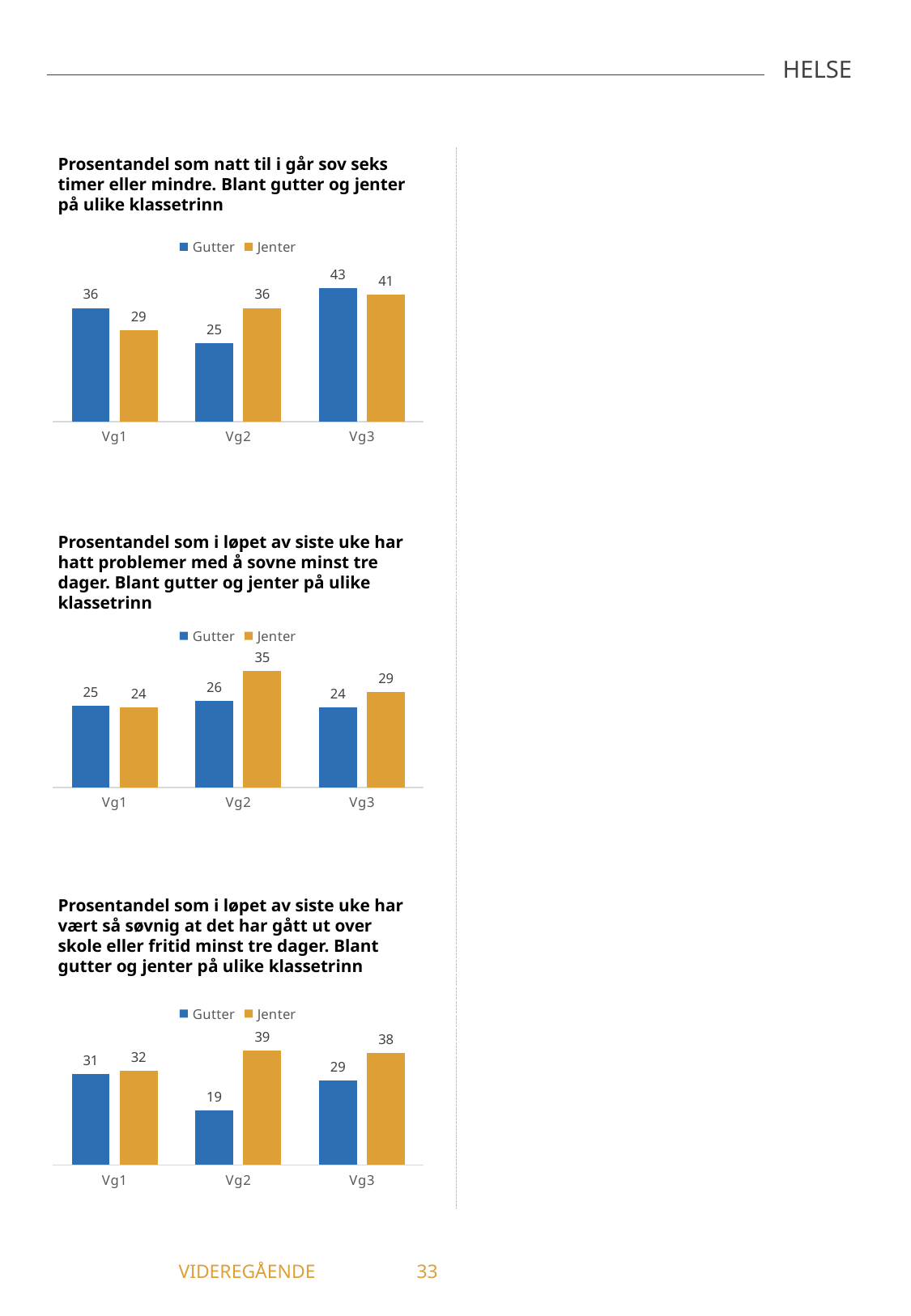
In the top chart (sleeping six hours or less), which class level has the lowest value for Gutter? Vg2 In the middle chart (problems falling asleep), which class level has the highest value for Jenter? Vg2 How many series does the legend of the top chart list? 2 In the top chart (sleeping six hours or less), what is the value for Jenter at Vg1? 29 In the top chart (sleeping six hours or less), what is the difference between Gutter and Jenter at Vg2? 11 What type of chart is the middle chart? Bar chart In the bottom chart (so sleepy it affected school or leisure), what is the value for Gutter at Vg2? 19 In the middle chart (problems falling asleep), which is larger at Vg3, Gutter or Jenter? Jenter In the bottom chart (so sleepy it affected school or leisure), which class level has the highest value for Jenter? Vg2 In the bottom chart (so sleepy it affected school or leisure), what is the difference between Jenter and Gutter at Vg2? 20 In the middle chart (problems falling asleep), what is the value for Jenter at Vg2? 35 In the top chart (sleeping six hours or less), what is the value for Gutter at Vg3? 43